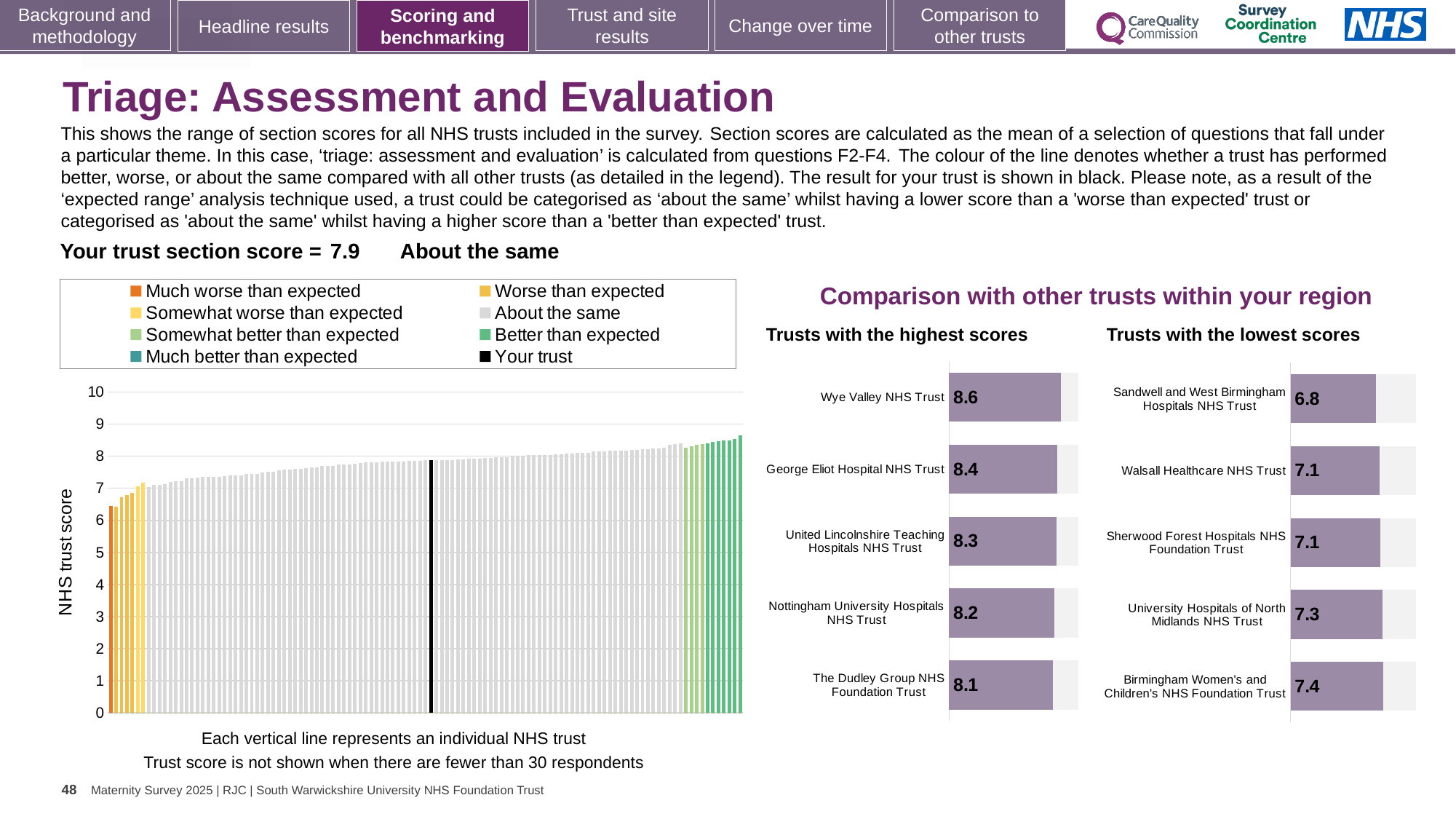
What is the section score for your trust shown on the slide? 7.9 How many trusts are shown in the 'Trusts with the highest scores' chart? 5 How many entries does the legend above the 'NHS trust score' chart list? 8 In the 'Trusts with the highest scores' chart, what is the difference between the scores of Wye Valley NHS Trust and The Dudley Group NHS Foundation Trust? 0.5 In the 'Trusts with the lowest scores' chart, which has the larger score: Walsall Healthcare NHS Trust or University Hospitals of North Midlands NHS Trust? University Hospitals of North Midlands NHS Trust In the 'Trusts with the lowest scores' chart, what is the score for Sandwell and West Birmingham Hospitals NHS Trust? 6.8 In the 'Trusts with the lowest scores' chart, what is the score for Birmingham Women's and Children's NHS Foundation Trust? 7.4 In the 'Trusts with the highest scores' chart, what is the score for Wye Valley NHS Trust? 8.6 In the 'Trusts with the lowest scores' chart, which trust has the lowest score? Sandwell and West Birmingham Hospitals NHS Trust In the 'Trusts with the highest scores' chart, which trust has the highest score? Wye Valley NHS Trust In the 'NHS trust score' chart, is the value for the lowest-scoring trust (the leftmost bar) greater or less than 7? less What kind of chart is the large 'NHS trust score' chart on the left of the slide? bar chart